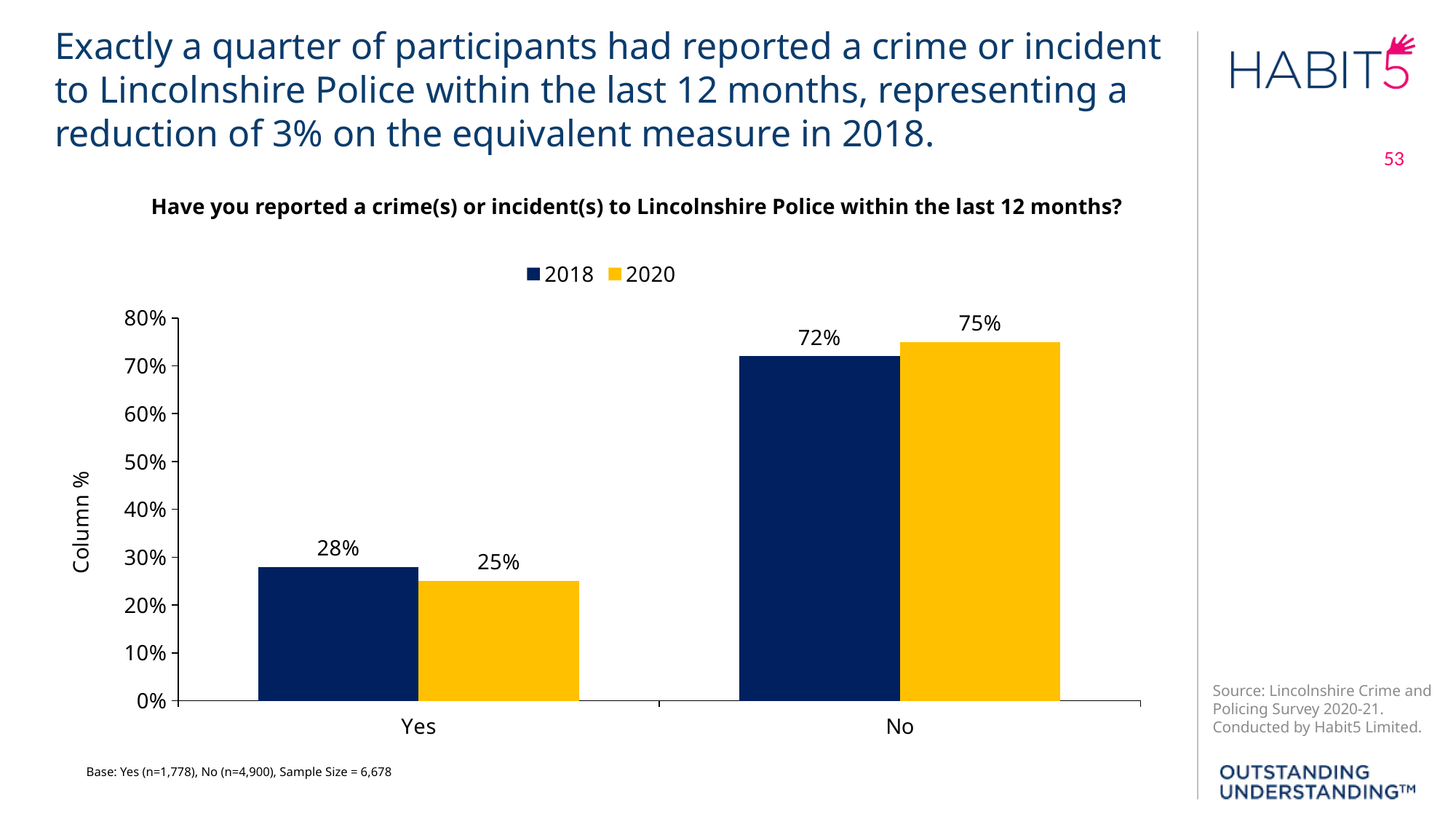
Which category has the lowest value for the 2018 series? Yes What percentage of participants answered Yes in 2018? 28% What percentage of participants answered No in 2018? 72% What percentage of participants answered Yes in 2020? 25% What percentage of participants answered No in 2020? 75% Which category has the highest value for the 2020 series? No What is the label of the y axis? Column % How many series does the legend list? 2 What is the difference between the 2018 and 2020 values for Yes? 3% How many categories are shown on the x axis? 2 Which is larger for the No category: the 2018 value or the 2020 value? 2020 What kind of chart is shown on the slide? Bar chart